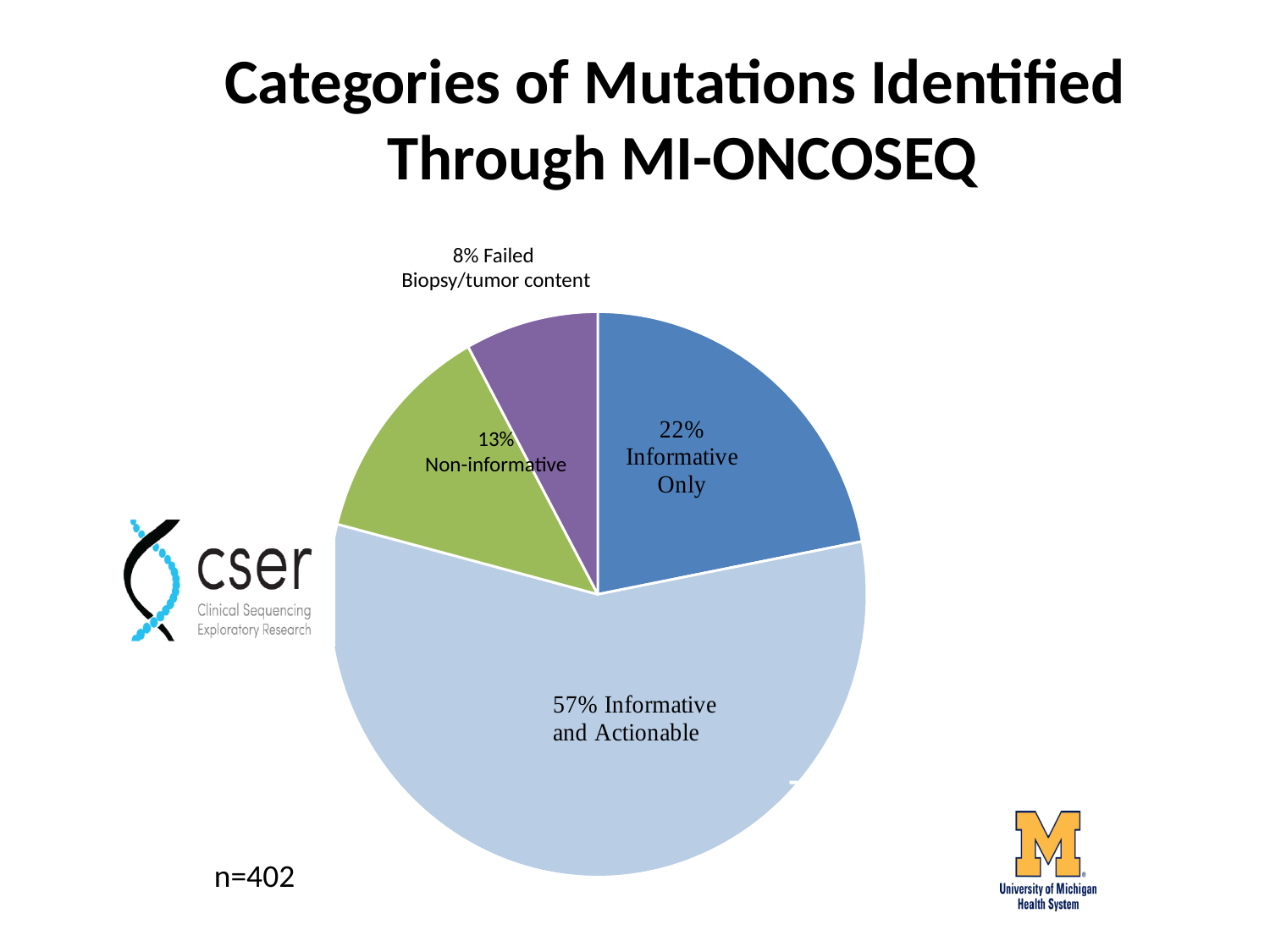
What is the title of the chart on the slide? Categories of Mutations Identified Through MI-ONCOSEQ How many categories are shown in the pie chart? 4 What share of the pie is Informative and Actionable? 57% What share of the pie is Failed Biopsy/tumor content? 8% Which category has the smallest slice of the pie? Failed Biopsy/tumor content Which category has the largest slice of the pie? Informative and Actionable What share of the pie is Informative Only? 22% Which is larger, the Non-informative slice or the Informative Only slice? Informative Only What is the sample size (n) stated on the slide? n=402 What kind of chart is shown on the slide? pie chart What is the difference in percentage points between Informative and Actionable and Informative Only? 35